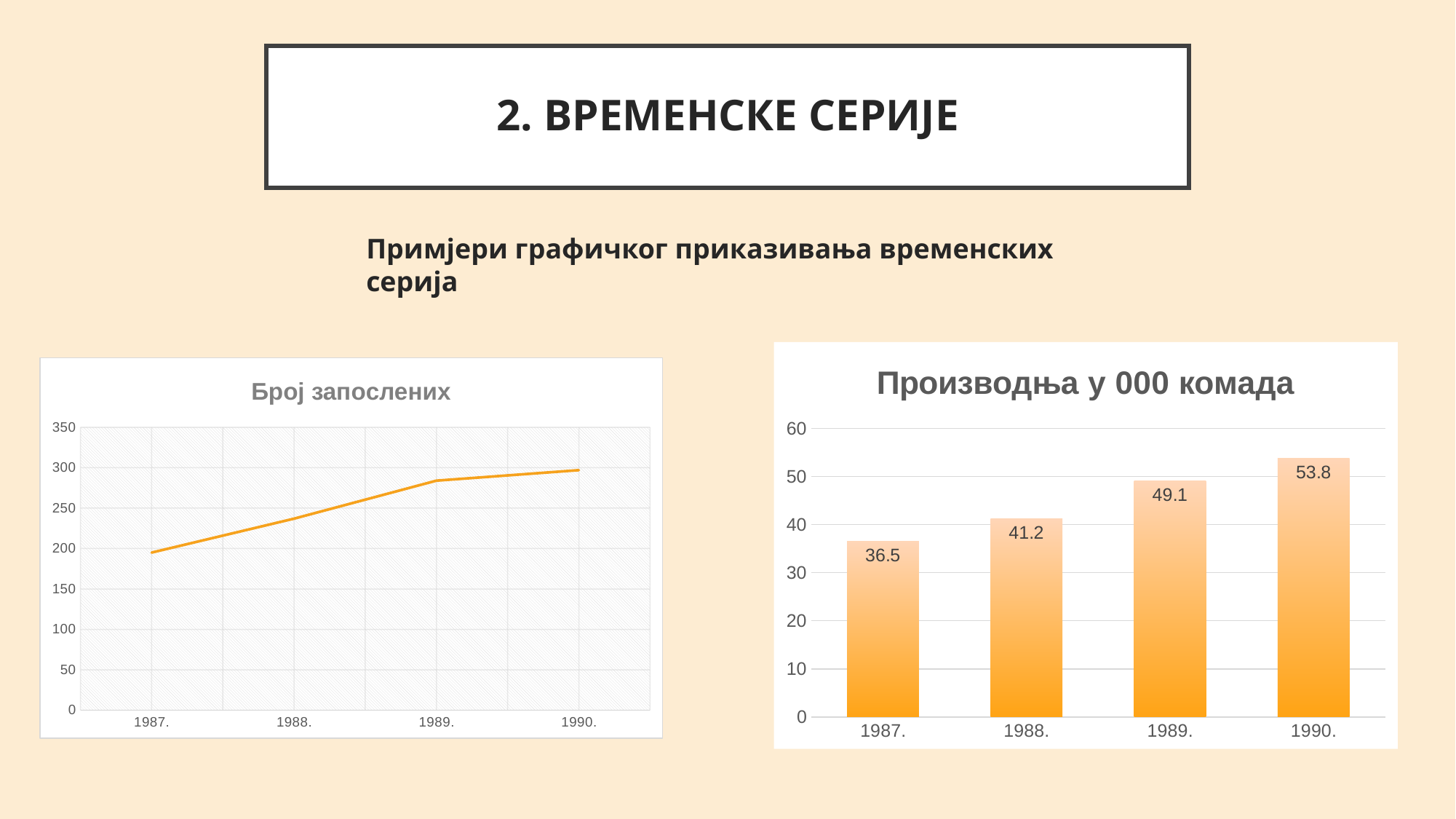
In the chart titled "Производња у 000 комада", which is larger, the value for 1988. or the value for 1989.? 1989. In the chart titled "Број запослених", is the value for 1990. greater or less than 250? greater In the chart titled "Број запослених", do the values rise or fall from 1987. to 1990.? rise What kind of chart is the chart titled "Број запослених"? line chart What kind of chart is the chart titled "Производња у 000 комада"? bar chart In the chart titled "Производња у 000 комада", what is the difference between the values for 1990. and 1987.? 17.3 In the chart titled "Производња у 000 комада", which year has the lowest value? 1987. In the chart titled "Производња у 000 комада", what is the value for 1988.? 41.2 In the chart titled "Производња у 000 комада", how many bars are there? 4 In the chart titled "Број запослених", is the value for 1987. greater or less than 250? less In the chart titled "Производња у 000 комада", which year has the highest value? 1990. In the chart titled "Производња у 000 комада", what is the value for 1990.? 53.8